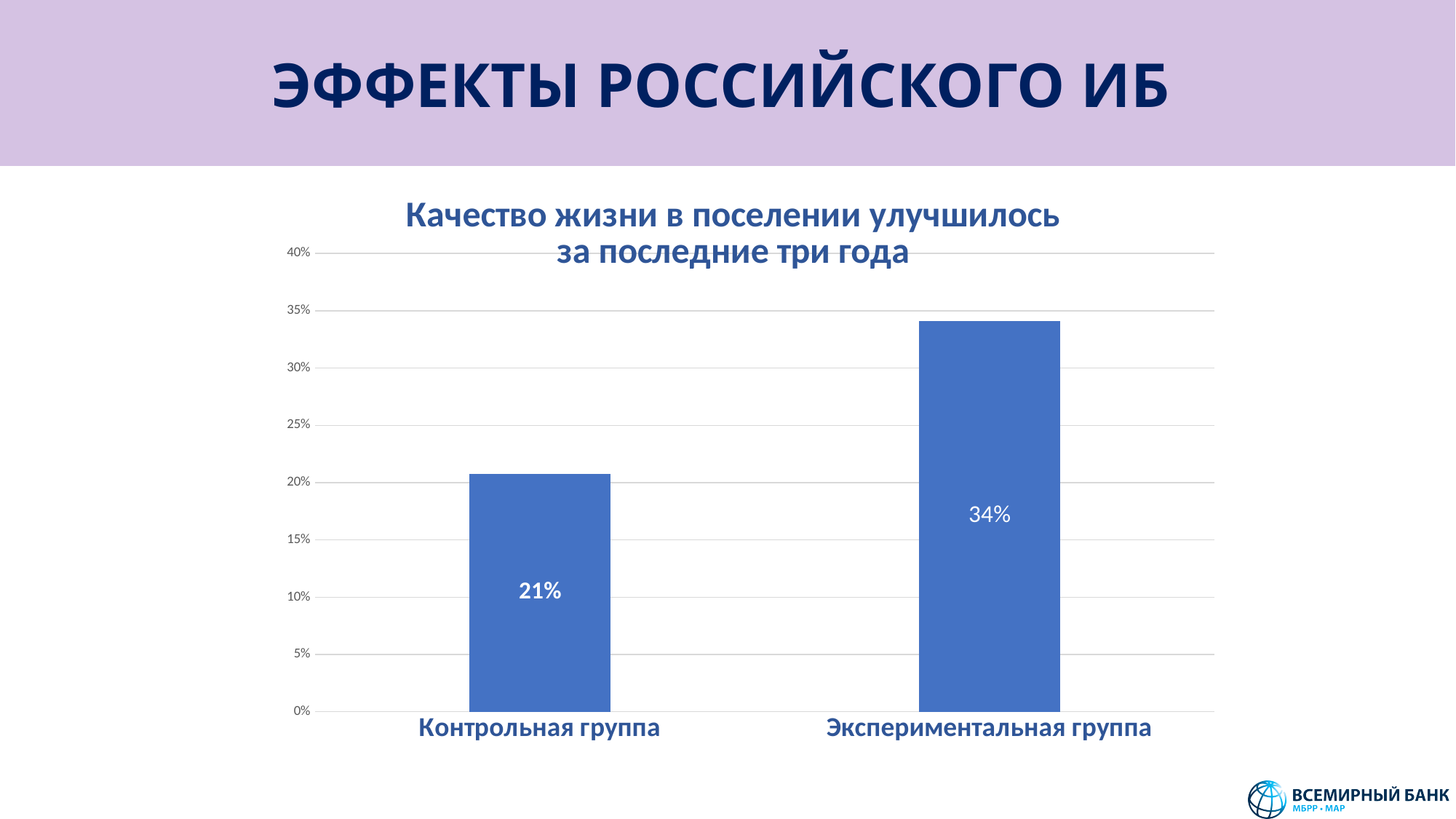
Which is larger, the value for Контрольная группа or for Экспериментальная группа? Экспериментальная группа Which group has the lowest value? Контрольная группа How many categories are shown in the chart? 2 What is the title of the chart? Качество жизни в поселении улучшилось за последние три года Which group has the highest value? Экспериментальная группа Is the value for Экспериментальная группа greater or less than 30%? greater What is the value for Контрольная группа? 21% What is the maximum value shown on the vertical axis? 40% What is the value for Экспериментальная группа? 34% Is the value for Контрольная группа greater or less than 25%? less What kind of chart is shown on the slide? bar chart What is the difference between the values for Экспериментальная группа and Контрольная группа? 13%